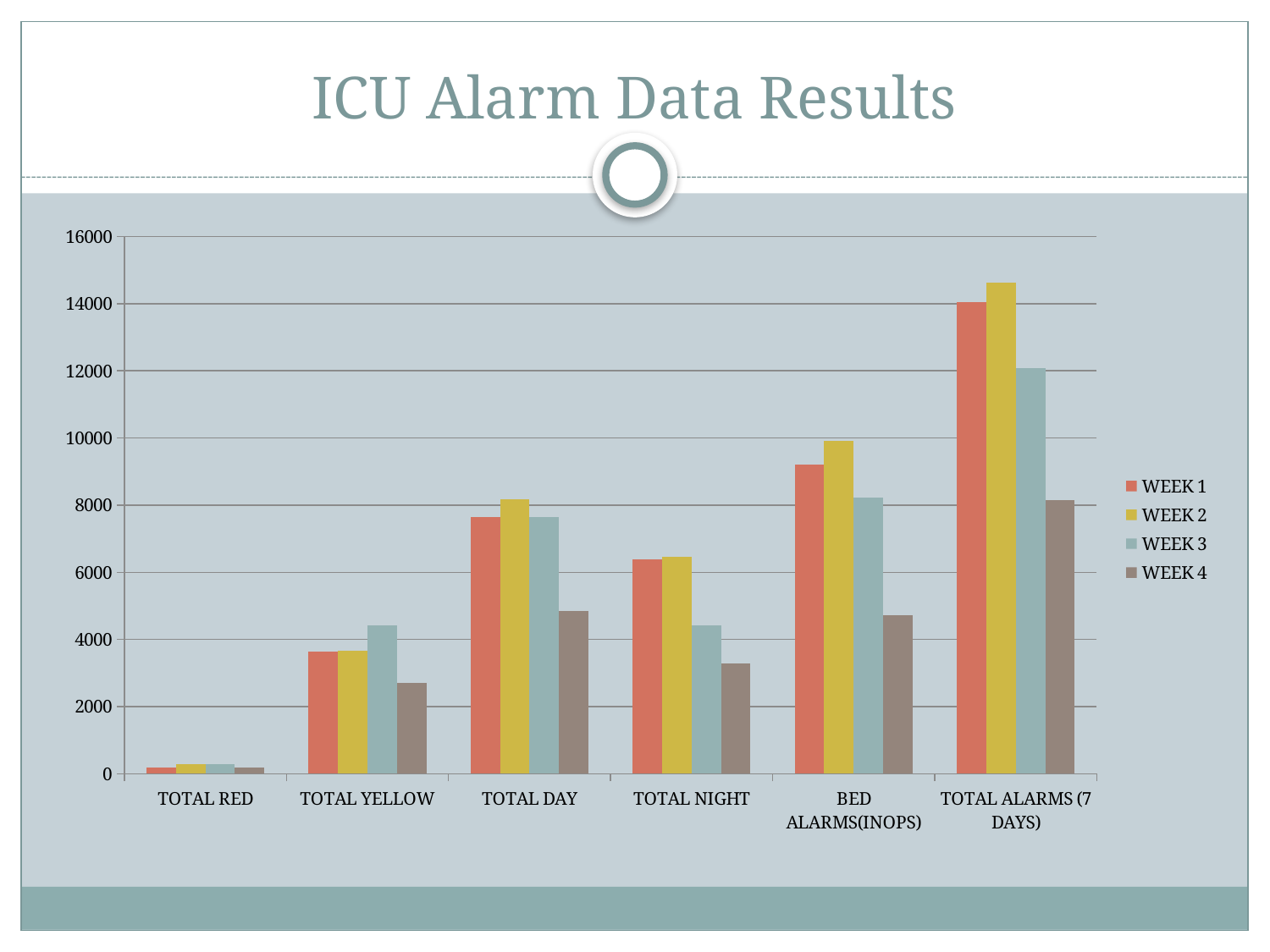
Is the WEEK 2 value for TOTAL ALARMS (7 DAYS) greater or less than 14000? greater How many series does the legend list? 4 Which category has the lowest bars overall? TOTAL RED Which category has the highest WEEK 2 bar? TOTAL ALARMS (7 DAYS) What is the title of the chart? ICU Alarm Data Results For BED ALARMS(INOPS), which is larger: the WEEK 1 value or the WEEK 3 value? WEEK 1 Within BED ALARMS(INOPS), which week has the lowest bar? WEEK 4 Is the WEEK 4 value for TOTAL DAY greater or less than 6000? less Within TOTAL ALARMS (7 DAYS), which week has the highest bar? WEEK 2 What kind of chart is shown on the slide? bar chart How many categories are shown along the x axis? 6 For TOTAL YELLOW, which is larger: the WEEK 3 value or the WEEK 4 value? WEEK 3